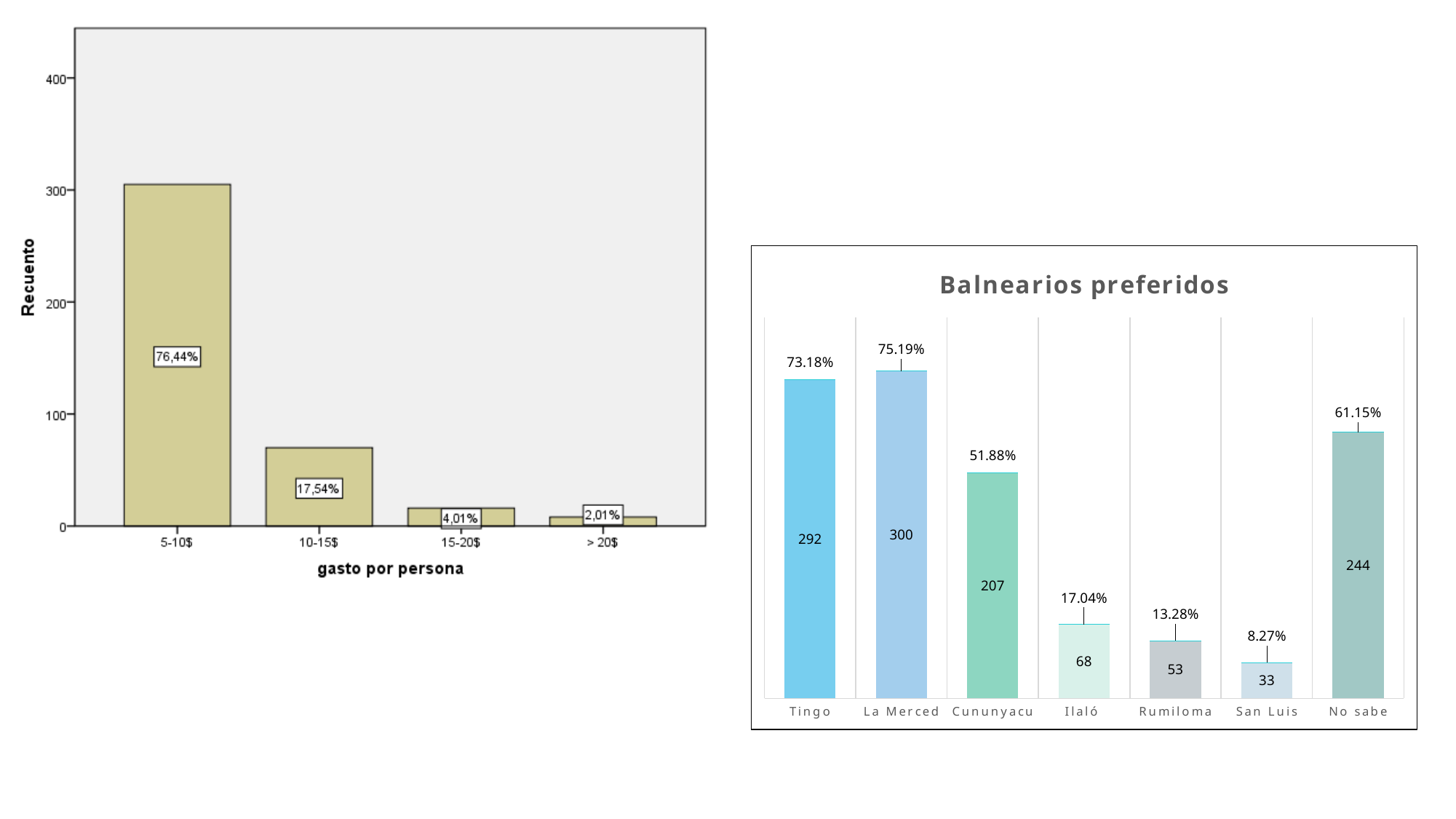
In the left chart (gasto por persona), is the count for 10-15$ greater or less than 100? less What type of chart is the Balnearios preferidos chart? Bar chart In the Balnearios preferidos chart, what is the difference between the counts for Tingo and No sabe? 48 In the left chart (gasto por persona), what percentage label is shown on the 5-10$ bar? 76,44% In the left chart (gasto por persona), what percentage label is shown on the 10-15$ bar? 17,54% In the Balnearios preferidos chart, what is the count for La Merced? 300 In the Balnearios preferidos chart, which category has the lowest value? San Luis In the left chart (gasto por persona), is the count for 5-10$ greater or less than 300? greater In the Balnearios preferidos chart, which is larger, the count for Ilaló or the count for Rumiloma? Ilaló In the Balnearios preferidos chart, what percentage is shown above the Cununyacu bar? 51.88% In the left chart (gasto por persona), which category has the lowest count? > 20$ In the left chart (gasto por persona), how many categories are shown on the x axis? 4